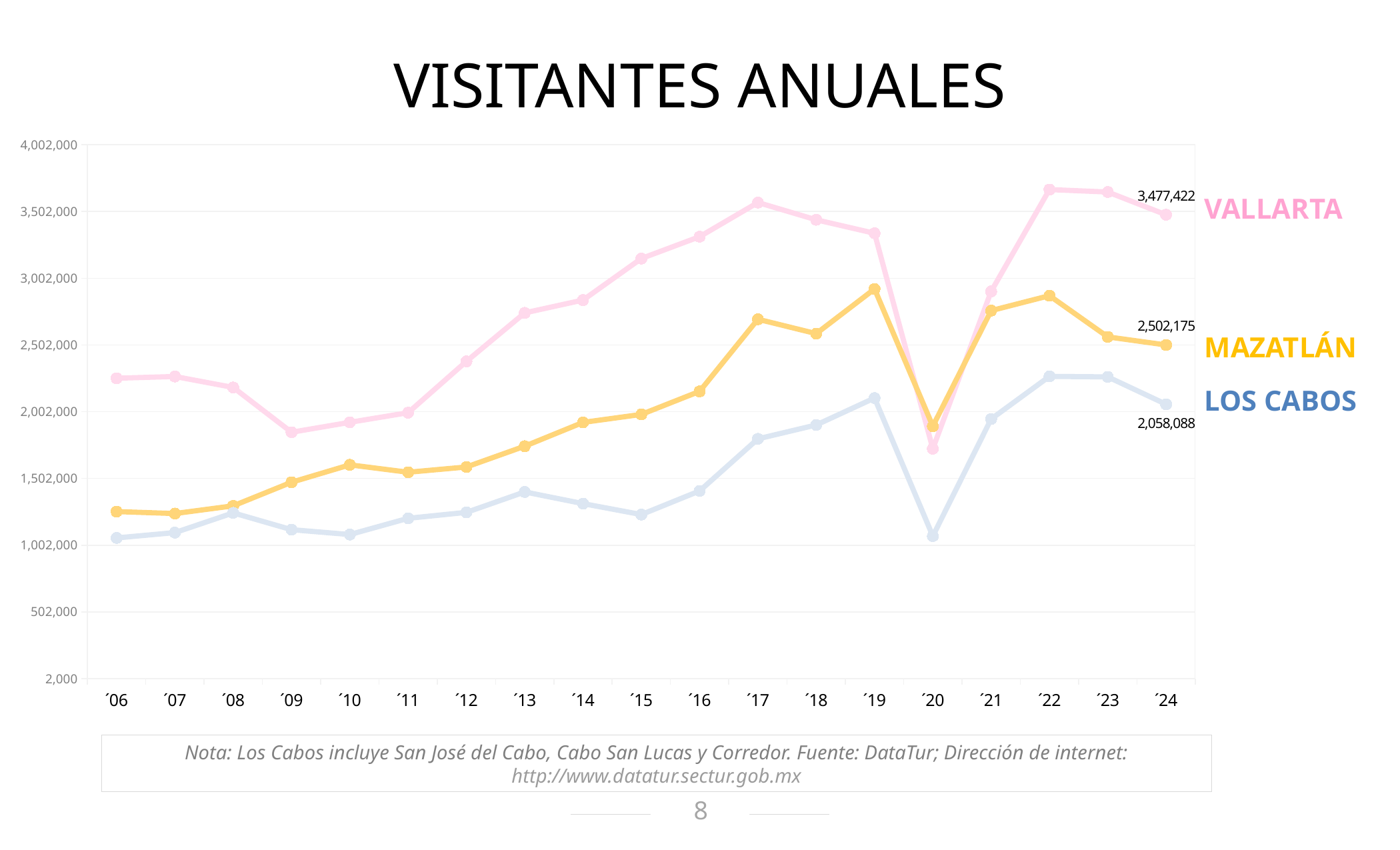
What is the difference between the Vallarta and Mazatlán values in '24? 975,247 Between '19 and '20, did the Vallarta line rise or fall? fall What kind of chart is shown on the slide? line chart Which series has the lowest value in '24? Los Cabos What is the value for Mazatlán in '24? 2,502,175 What is the value for Vallarta in '24? 3,477,422 Which series has the highest value in '24? Vallarta How many years are plotted along the x axis? 19 What is the value for Los Cabos in '24? 2,058,088 What is the difference between the Mazatlán and Los Cabos values in '24? 444,087 Is the value for Los Cabos in '20 greater or less than 1,502,000? less How many series does the chart show? 3